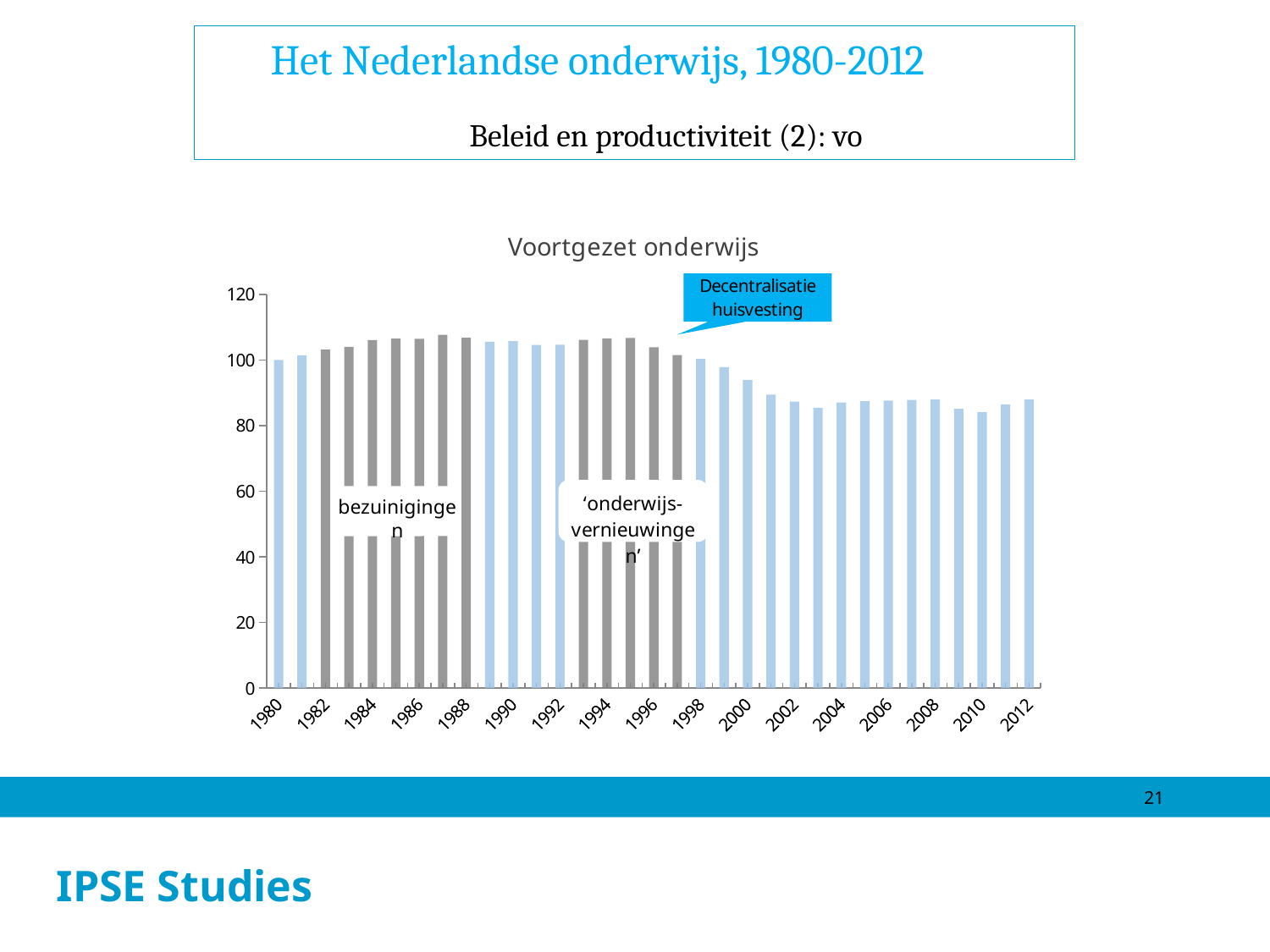
What label does the callout box above the bars around 1997-1998 show? Decentralisatie huisvesting Do the values generally rise or fall from 1998 to 2012? fall How many years (bars) are plotted in the chart, from 1980 to 2012? 33 What is the title of the chart? Voortgezet onderwijs Is the value for 2005 greater or less than 80? greater Is the value for 1987 greater or less than 100? greater Is the value for 2012 greater or less than 100? less What kind of chart is shown on the slide? bar chart Which is larger, the value for 1987 or the value for 2012? 1987 Which is larger, the value for 1980 or the value for 2010? 1980